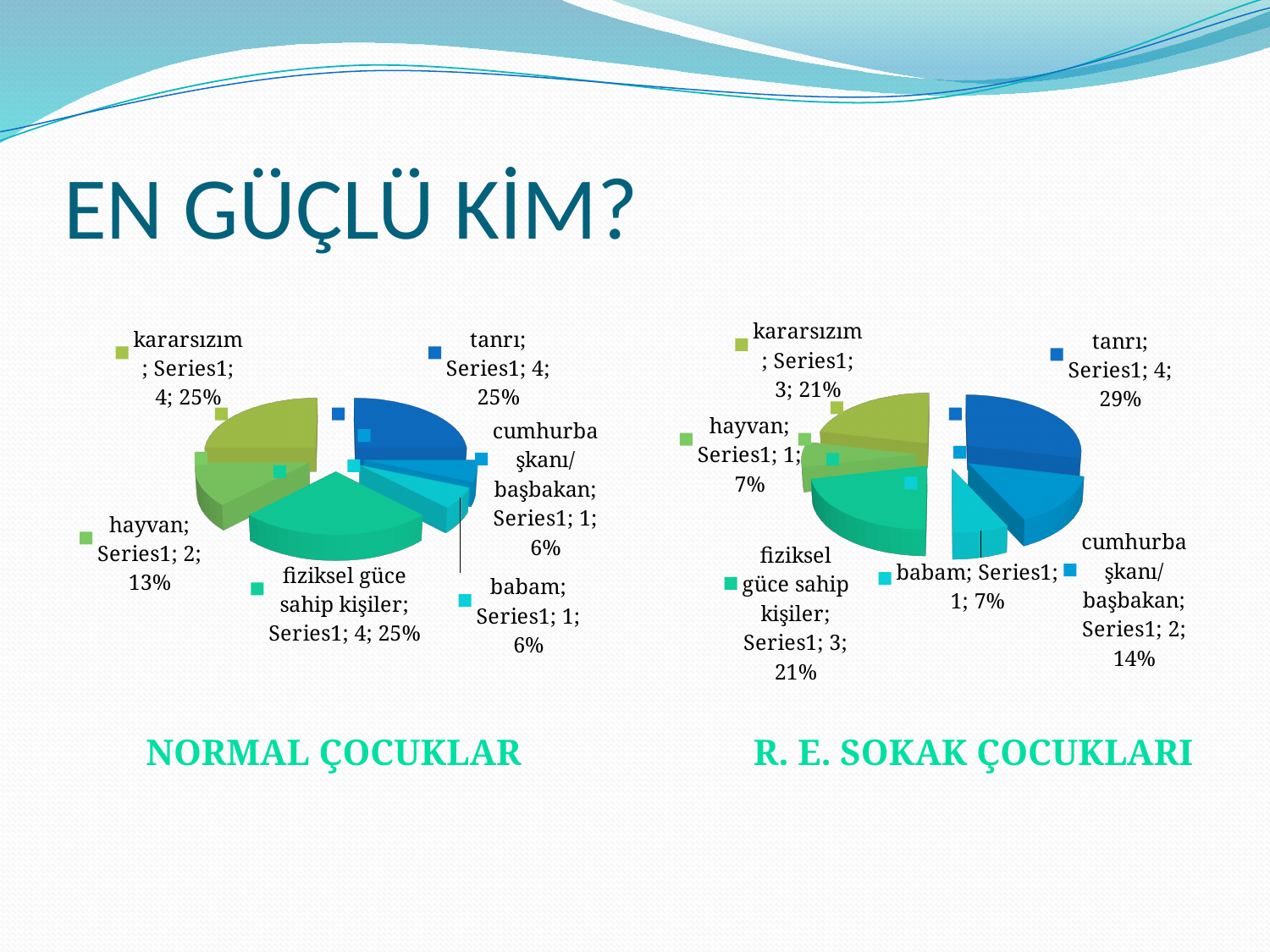
In the NORMAL ÇOCUKLAR chart, which is larger, the share for 'hayvan' or the share for 'babam'? hayvan In the R. E. SOKAK ÇOCUKLARI chart, which category has the largest share? tanrı In the R. E. SOKAK ÇOCUKLARI chart, which is larger, the share for 'kararsızım' or the share for 'hayvan'? kararsızım In the R. E. SOKAK ÇOCUKLARI chart, what is the value for 'kararsızım'? 3 In the NORMAL ÇOCUKLAR chart, what percentage share does 'babam' have? 6% In the NORMAL ÇOCUKLAR chart, what is the value for 'fiziksel güce sahip kişiler'? 4 How many categories are shown in the NORMAL ÇOCUKLAR pie chart? 6 What type of chart is used for NORMAL ÇOCUKLAR? Pie chart In the R. E. SOKAK ÇOCUKLARI chart, what percentage share does 'cumhurbaşkanı/başbakan' have? 14% In the NORMAL ÇOCUKLAR chart, what percentage share does the 'hayvan' slice have? 13% In the R. E. SOKAK ÇOCUKLARI chart, what is the difference in value between 'tanrı' and 'fiziksel güce sahip kişiler'? 1 What is the title of the slide? EN GÜÇLÜ KİM?